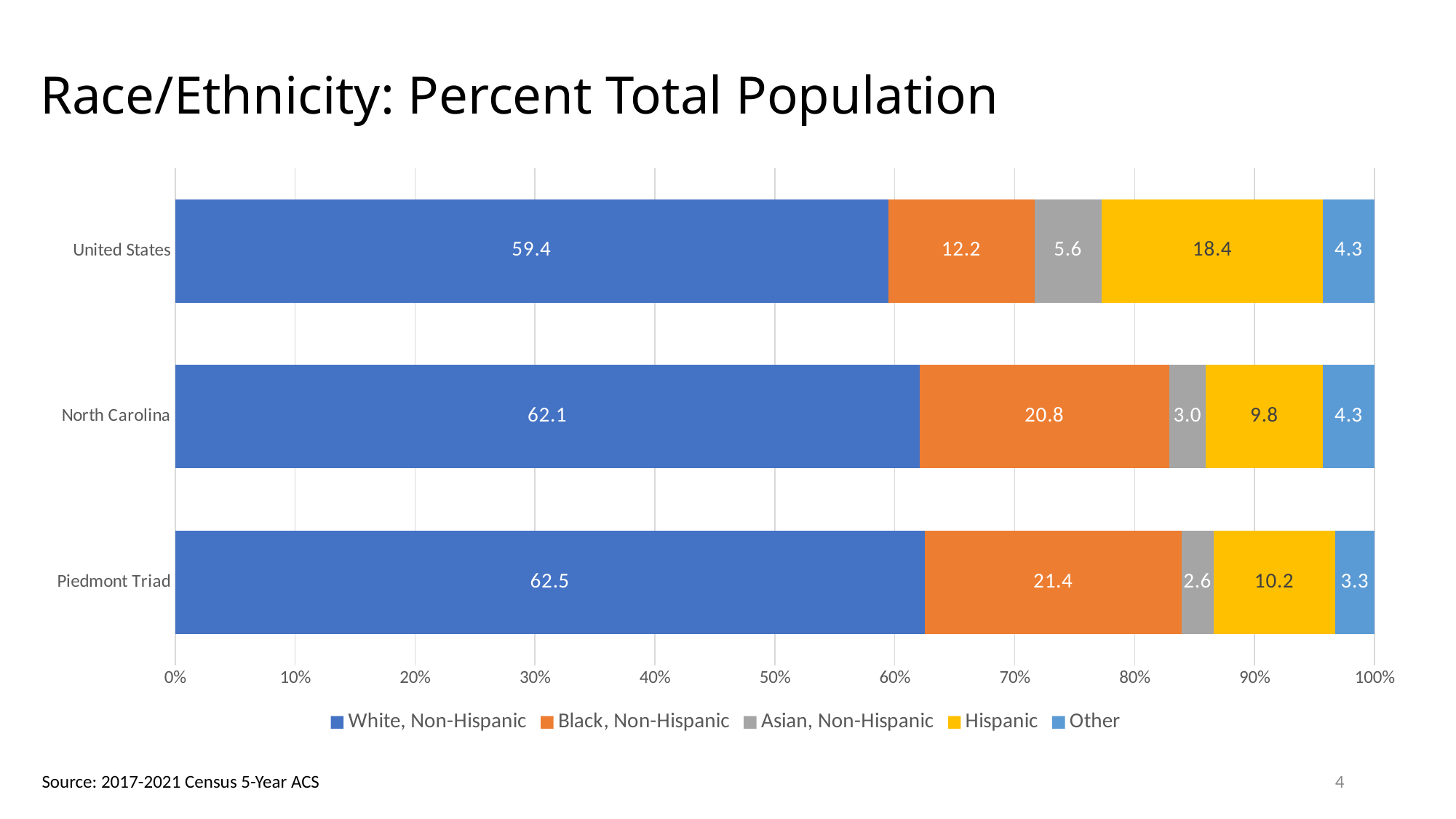
What is the Hispanic value for North Carolina? 9.8 What is the Black, Non-Hispanic value for the Piedmont Triad? 21.4 Which category has the highest Hispanic value? United States Which is larger, the Asian, Non-Hispanic value for North Carolina or for the Piedmont Triad? North Carolina How many series does the legend list? 5 What is the difference between the Black, Non-Hispanic values for the Piedmont Triad and the United States? 9.2 What is the title of the chart? Race/Ethnicity: Percent Total Population What is the White, Non-Hispanic value for the United States? 59.4 How many categories are shown on the chart? 3 What kind of chart is shown on the slide? Stacked bar chart Which category has the lowest Other value? Piedmont Triad What is the Asian, Non-Hispanic value for the United States? 5.6